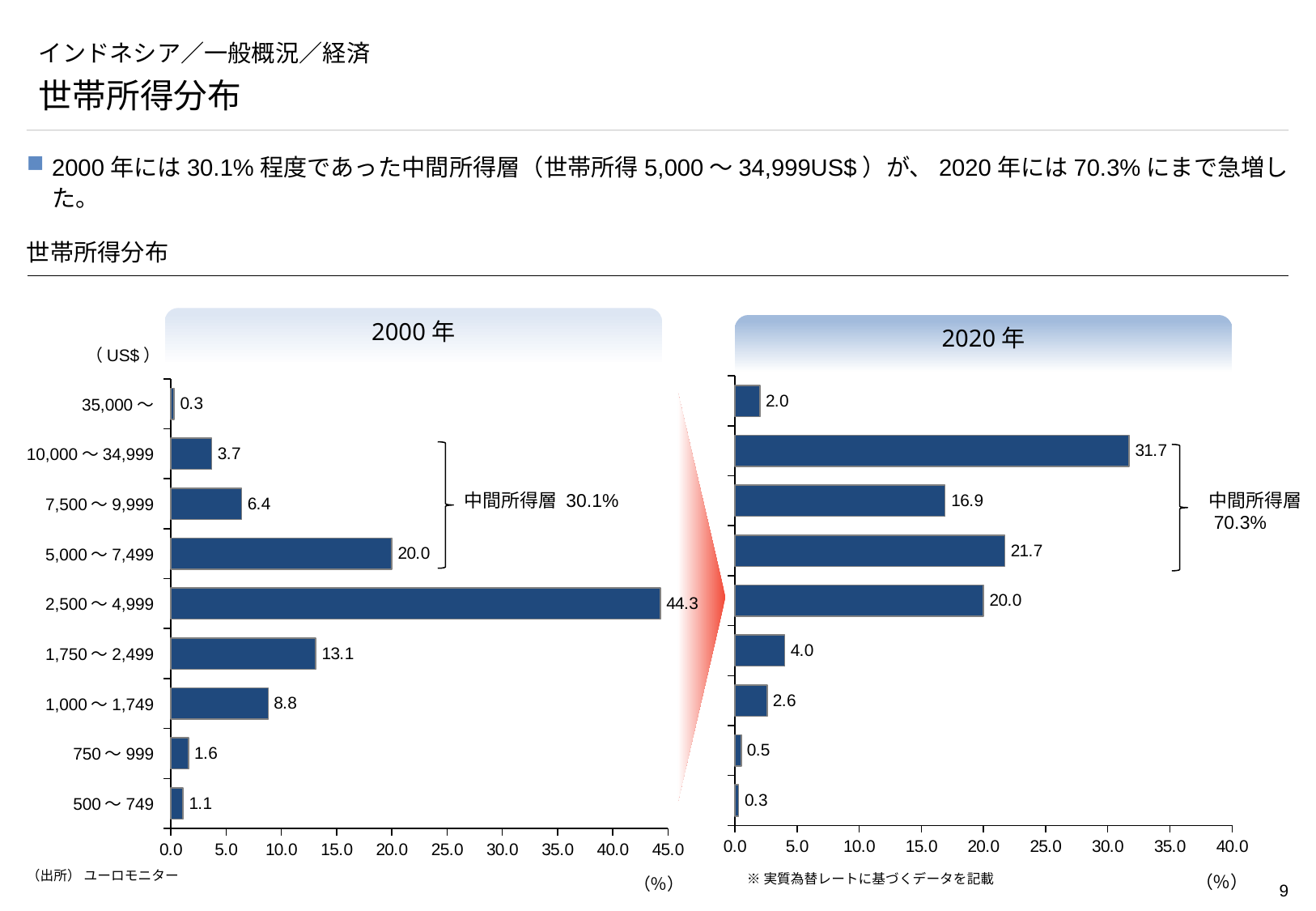
In the 2000年 chart, what is the value for the 2,500～4,999 income bracket? 44.3 In the 2000年 chart, which is larger: the value for 1,750～2,499 or the value for 1,000～1,749? 1,750～2,499 What kind of chart is the 2020年 chart? Bar chart In the 2020年 chart, is the value for 7,500～9,999 greater or less than 15.0? greater In the 2020年 chart, which income bracket has the highest value? 10,000～34,999 In the 2000年 chart, what is the total of the values for 10,000～34,999, 7,500～9,999 and 5,000～7,499? 30.1 In the 2020年 chart, what is the value for the 10,000～34,999 income bracket? 31.7 In the 2020年 chart, what is the difference between the values for 5,000～7,499 and 2,500～4,999? 1.7 How many income brackets are shown in the 2000年 chart? 9 What share of households does the 中間所得層 bracket represent in the 2020年 chart, according to the annotation? 70.3% What is the value for the 35,000～ bracket in the 2020年 chart? 2.0 In the 2000年 chart, which income bracket has the lowest value? 35,000～